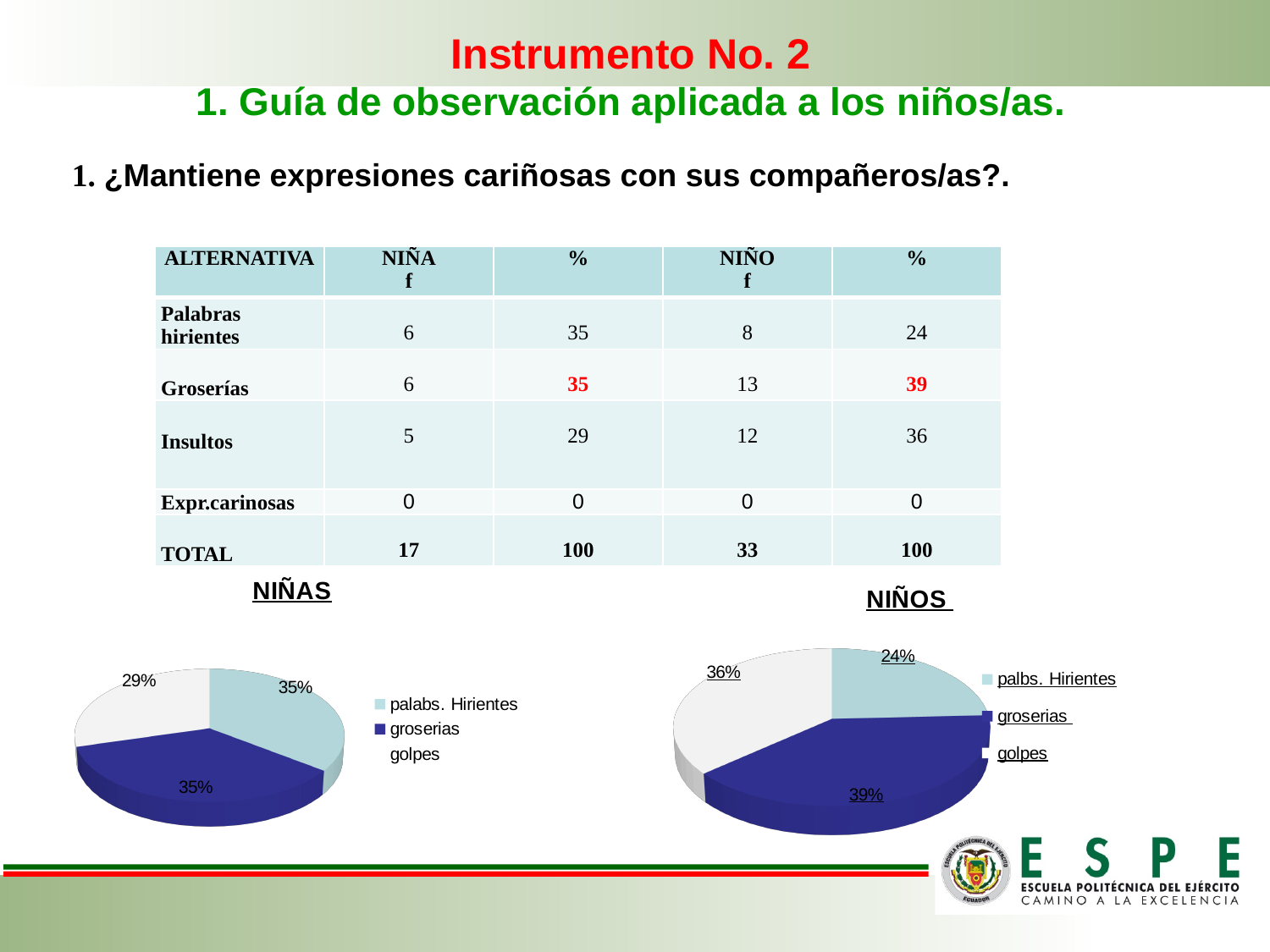
In the NIÑOS pie chart, what percentage is shown for groserias? 39% How many categories does the legend of the NIÑOS chart list? 3 In the NIÑOS pie chart, which category has the largest share? groserias In the NIÑOS pie chart, which category has the smallest share? palabs. Hirientes In the NIÑOS pie chart, what is the difference in percentage points between groserias and palabs. Hirientes? 15 In the NIÑOS pie chart, what percentage is shown for palabs. Hirientes? 24% What type of chart is used for the NIÑAS data? Pie chart In the NIÑAS pie chart, what percentage is shown for groserias? 35% In the NIÑAS pie chart, which is larger, the share for palabs. Hirientes or the share for golpes? palabs. Hirientes In the NIÑAS pie chart, which category has the smallest share? golpes In the NIÑOS pie chart, what percentage is shown for golpes? 36% In the NIÑAS pie chart, what percentage is shown for golpes? 29%